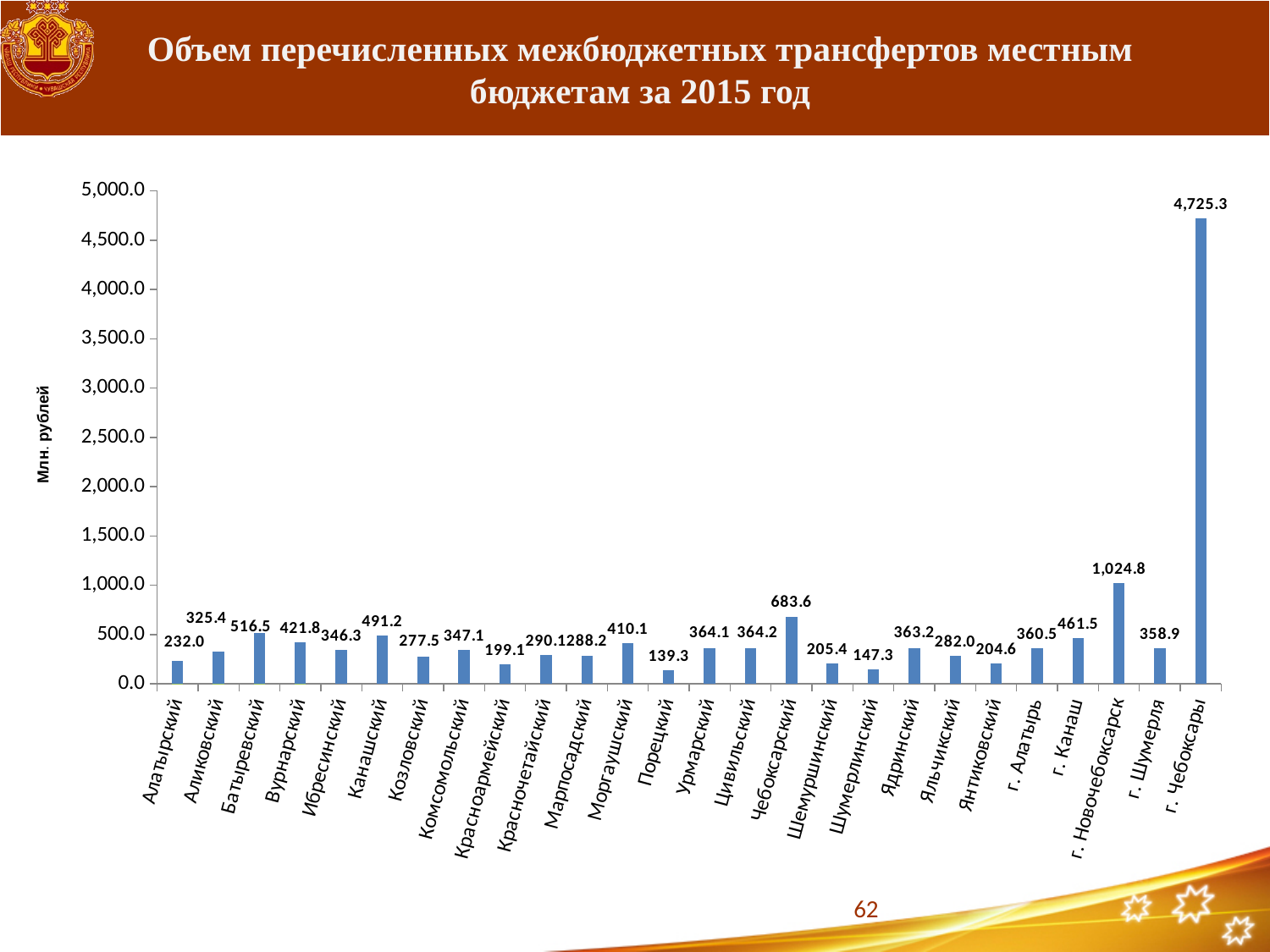
What is the difference between the values for г. Чебоксары and г. Новочебоксарск? 3,700.5 What is the value for Чебоксарский? 683.6 What is the value for Порецкий? 139.3 Is the value for г. Чебоксары greater or less than 4,500.0? greater Which is larger, the value for Батыревский or the value for Канашский? Батыревский What is the value for г. Новочебоксарск? 1,024.8 Which category has the lowest value? Порецкий Which category has the highest value? г. Чебоксары How many categories are shown on the x axis? 26 What kind of chart is shown on the slide? bar chart What is the value for г. Чебоксары? 4,725.3 What is the difference between the values for Чебоксарский and Порецкий? 544.3